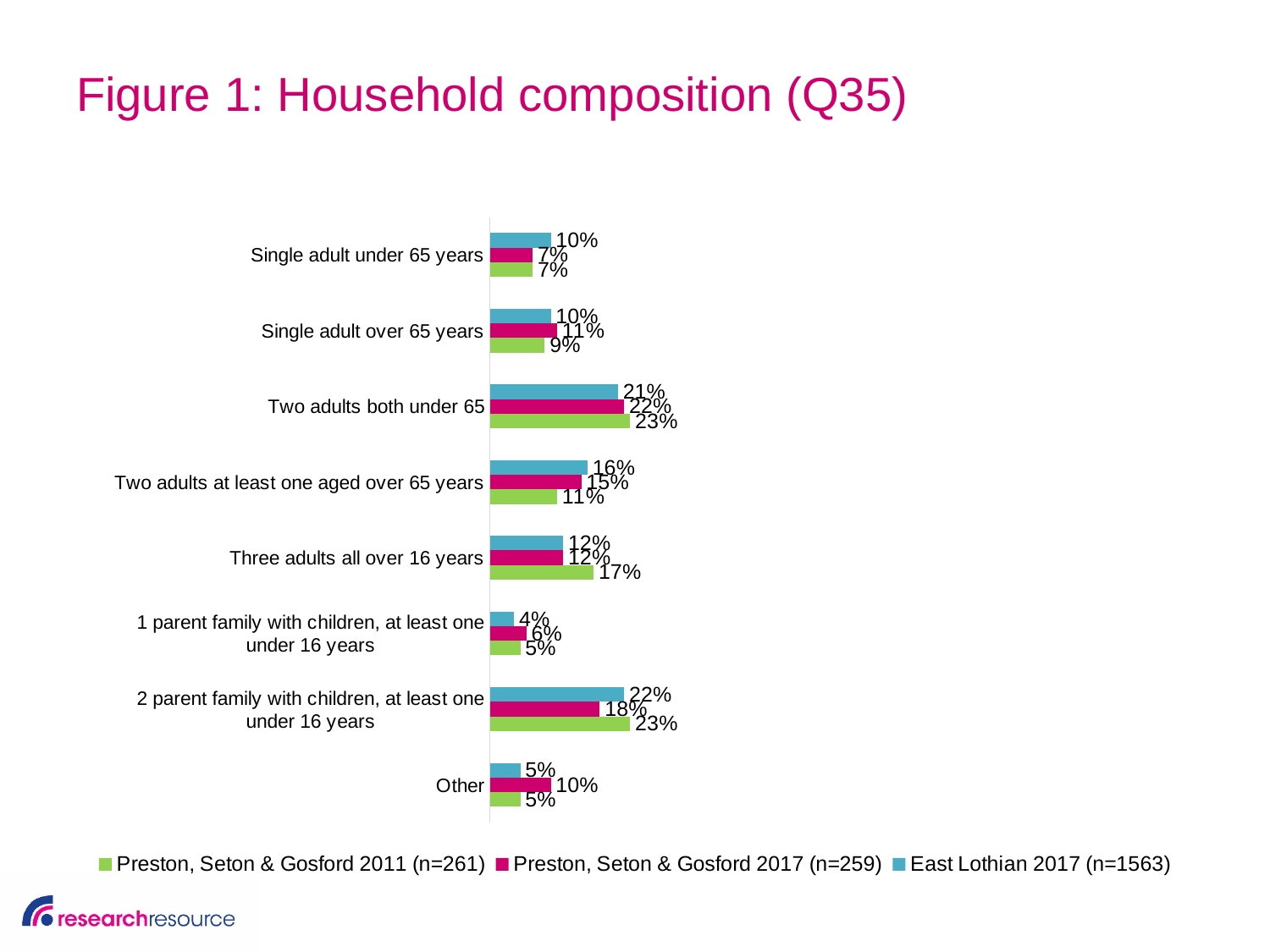
How many series does the legend list? 3 Which category has the highest value for Preston, Seton & Gosford 2017? Two adults both under 65 What is the value for Preston, Seton & Gosford 2017 for 'Other'? 10% What is the value for Preston, Seton & Gosford 2017 for '2 parent family with children, at least one under 16 years'? 18% Which category has the lowest value for East Lothian 2017? 1 parent family with children, at least one under 16 years How many household composition categories are shown on the chart? 8 What is the value for East Lothian 2017 for 'Single adult under 65 years'? 10% What colour represents the East Lothian 2017 (n=1563) series? blue What is the value for Preston, Seton & Gosford 2011 for 'Three adults all over 16 years'? 17% What is the difference between the Preston, Seton & Gosford 2011 and East Lothian 2017 values for 'Two adults at least one aged over 65 years'? 5% What type of chart is shown on the slide? bar chart For 'Three adults all over 16 years', which is larger: the Preston, Seton & Gosford 2011 value or the Preston, Seton & Gosford 2017 value? Preston, Seton & Gosford 2011